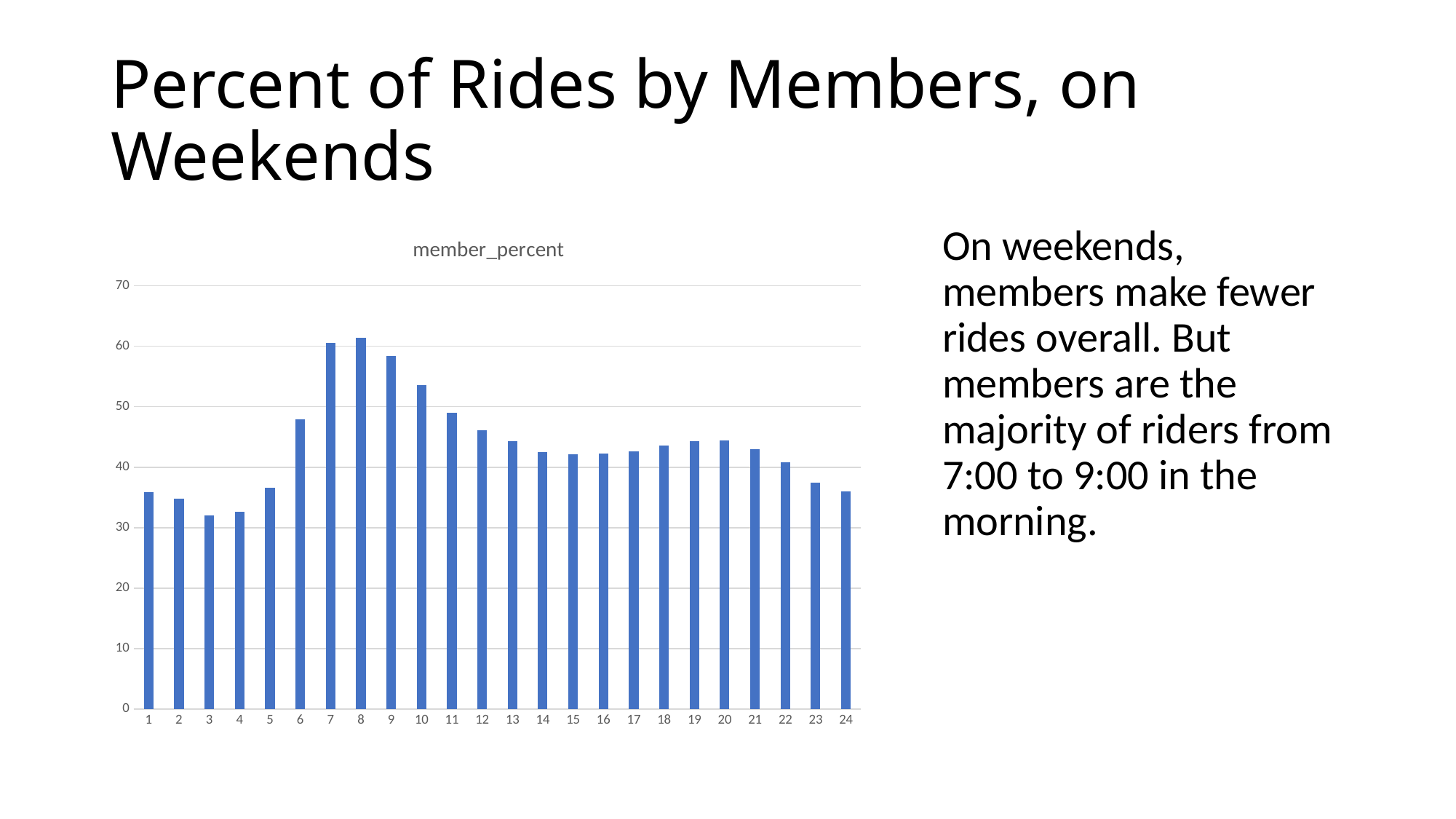
Do the values rise or fall from category 8 to category 16? fall What kind of chart is shown on the slide? bar chart Which has the larger value, category 10 or category 13? 10 Is the value for category 8 greater or less than 60? greater Is the value for category 10 greater or less than 50? greater Which has the larger value, category 7 or category 3? 7 What is the title shown above the chart? member_percent Is the value for category 6 greater or less than 50? less Which category has the highest member_percent value? 8 How many categories (hours) are plotted on the x axis? 24